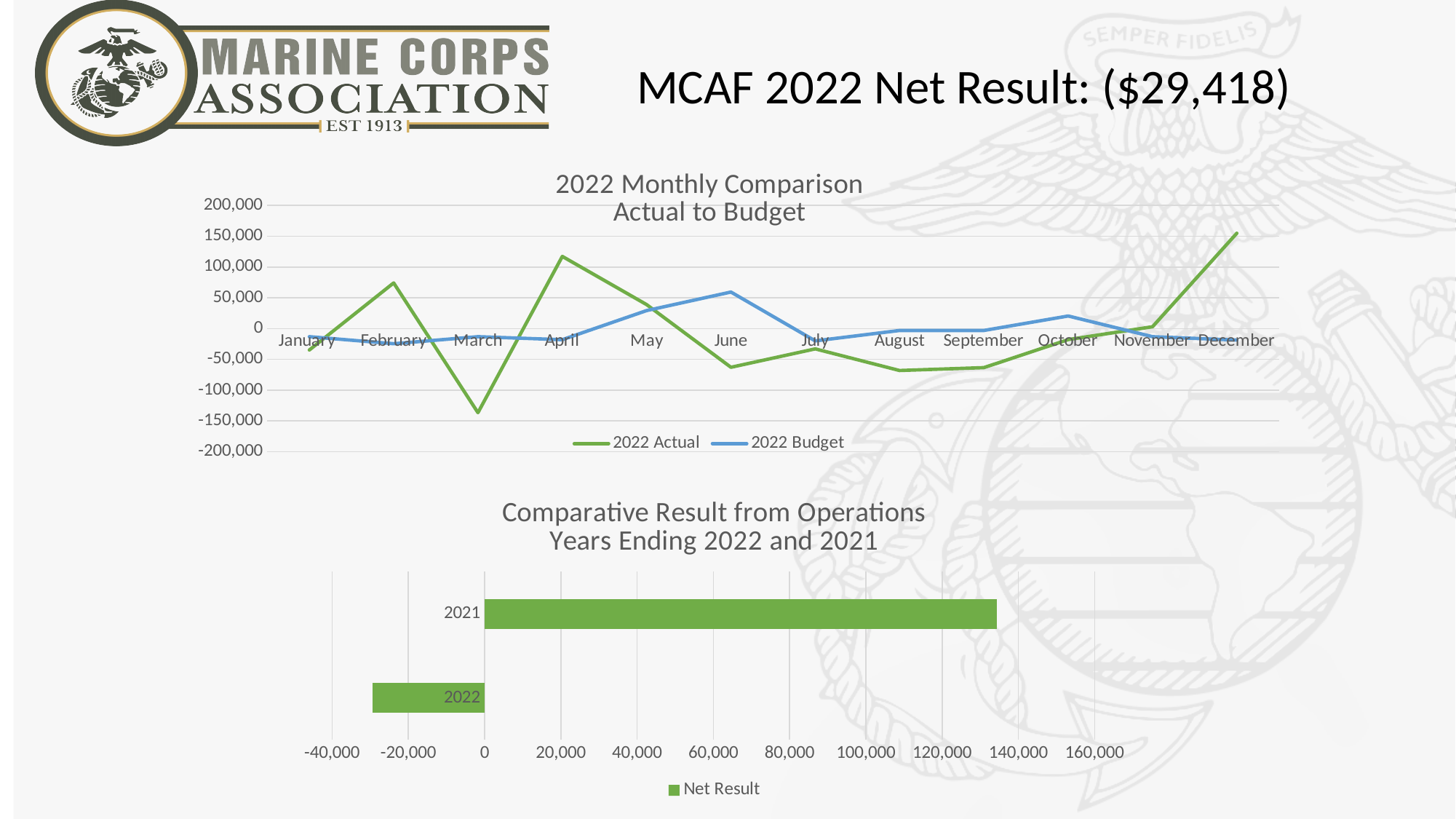
In the "Comparative Result from Operations" chart, is the Net Result for 2021 greater or less than 120,000? greater In the "Comparative Result from Operations" chart, which year has the larger Net Result, 2021 or 2022? 2021 In the "2022 Monthly Comparison Actual to Budget" chart, how many months are plotted along the x axis? 12 In the "2022 Monthly Comparison Actual to Budget" chart, which month has the lowest 2022 Actual value? March In the "2022 Monthly Comparison Actual to Budget" chart, which month has the highest 2022 Actual value? December In the "Comparative Result from Operations" chart, what is the name of the series shown in the legend? Net Result What kind of chart is the "2022 Monthly Comparison Actual to Budget" chart? line chart In the "2022 Monthly Comparison Actual to Budget" chart, which is larger in June, 2022 Actual or 2022 Budget? 2022 Budget In the "2022 Monthly Comparison Actual to Budget" chart, how many series does the legend list? 2 In the "2022 Monthly Comparison Actual to Budget" chart, is the 2022 Actual value for April greater or less than 100,000? greater What kind of chart is the "Comparative Result from Operations Years Ending 2022 and 2021" chart? bar chart In the "2022 Monthly Comparison Actual to Budget" chart, is the 2022 Actual value for March greater or less than -100,000? less